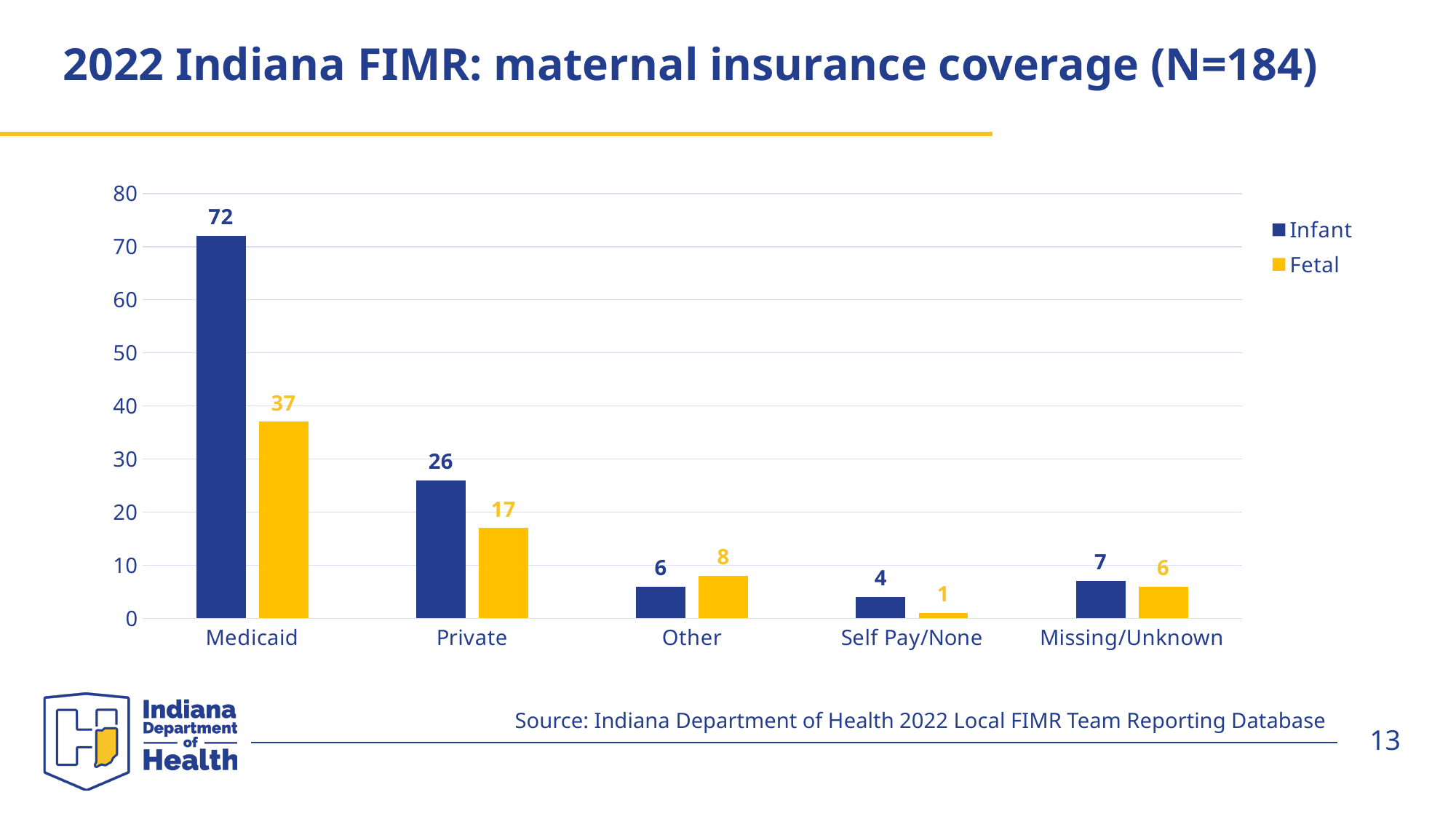
What is the Infant value for Medicaid? 72 Which is larger for Other, the Infant value or the Fetal value? Fetal How many categories are shown on the x axis? 5 What is the Fetal value for Private? 17 Which category has the lowest Fetal value? Self Pay/None What is the difference between the Infant and Fetal values for Medicaid? 35 Which category has the highest Infant value? Medicaid How many series does the legend list? 2 What colour are the Fetal bars? Yellow What is the Fetal value for Self Pay/None? 1 Is the Infant value for Private greater or less than 20? greater What kind of chart is shown on the slide? Bar chart